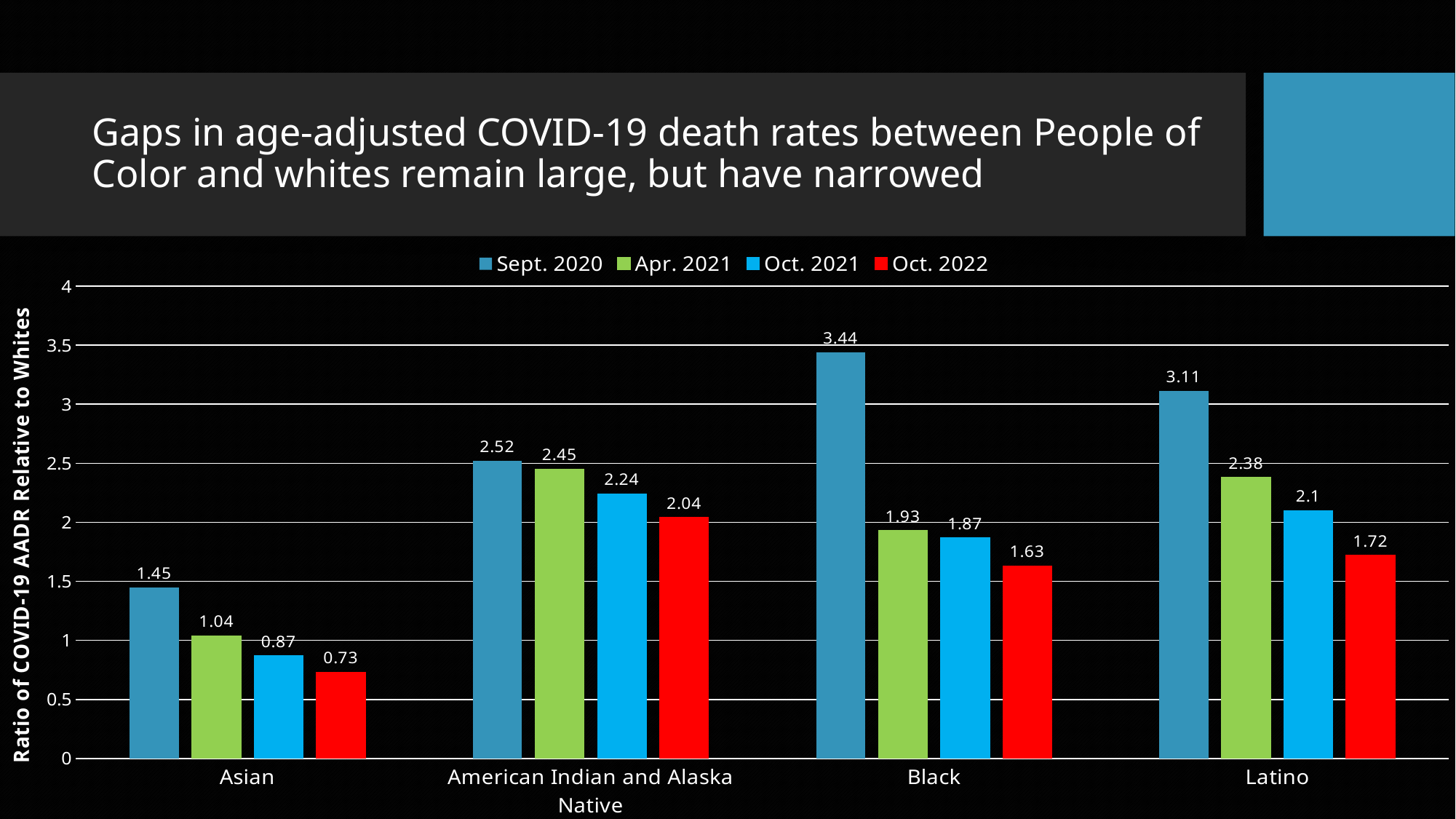
How many series does the legend list? 4 What is the Oct. 2022 value for Asian? 0.73 What is the difference between the Sept. 2020 and Oct. 2022 values for Latino? 1.39 Which category has the lowest Oct. 2022 value? Asian What is the Oct. 2021 value for American Indian and Alaska Native? 2.24 What is the Apr. 2021 value for Latino? 2.38 Which is larger, the Oct. 2021 value for Black or the Oct. 2021 value for Latino? Latino Which category has the highest Sept. 2020 value? Black What kind of chart is shown on the slide? Bar chart Do the values for Black rise or fall from Sept. 2020 to Oct. 2022? Fall How many categories are shown on the x axis? 4 What is the Sept. 2020 value for Black? 3.44